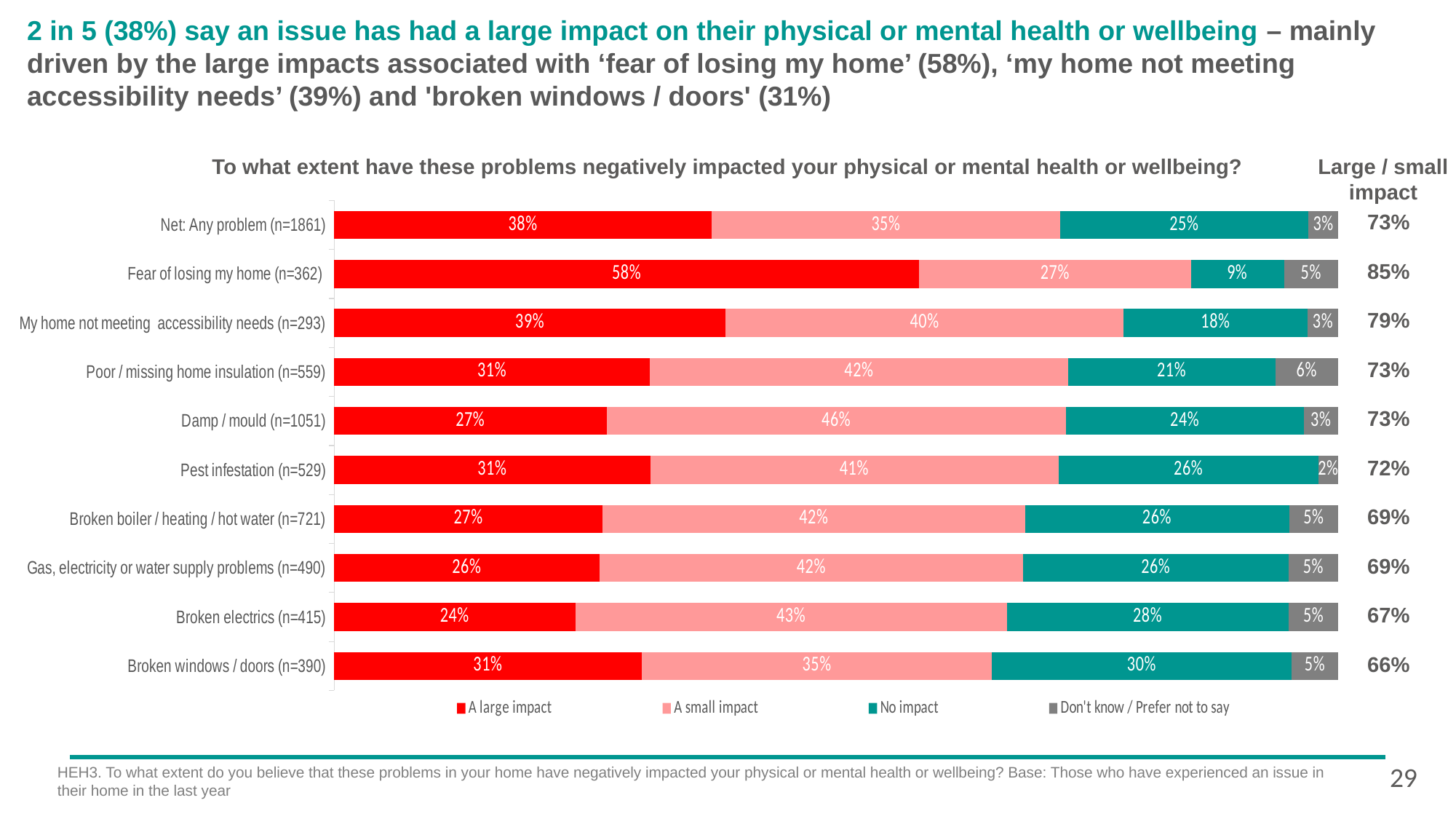
Which category has the lowest 'A large impact' value? Broken electrics What kind of chart is shown on the slide? Stacked bar chart What percentage of respondents with 'Fear of losing my home' reported a large impact? 58% Which has a larger 'No impact' value: 'Broken electrics' or 'Damp / mould'? Broken electrics Which category has the highest 'A large impact' value? Fear of losing my home What colour represents 'No impact' in the chart? Teal How many series does the legend list? 4 What is the combined 'Large / small impact' value shown for 'My home not meeting accessibility needs'? 79% What is the 'A small impact' value for 'Damp / mould'? 46% What is the 'No impact' value for 'Broken windows / doors'? 30% How many categories are shown on the chart? 10 What is the difference between the 'A large impact' values for 'Fear of losing my home' and 'Net: Any problem'? 20%